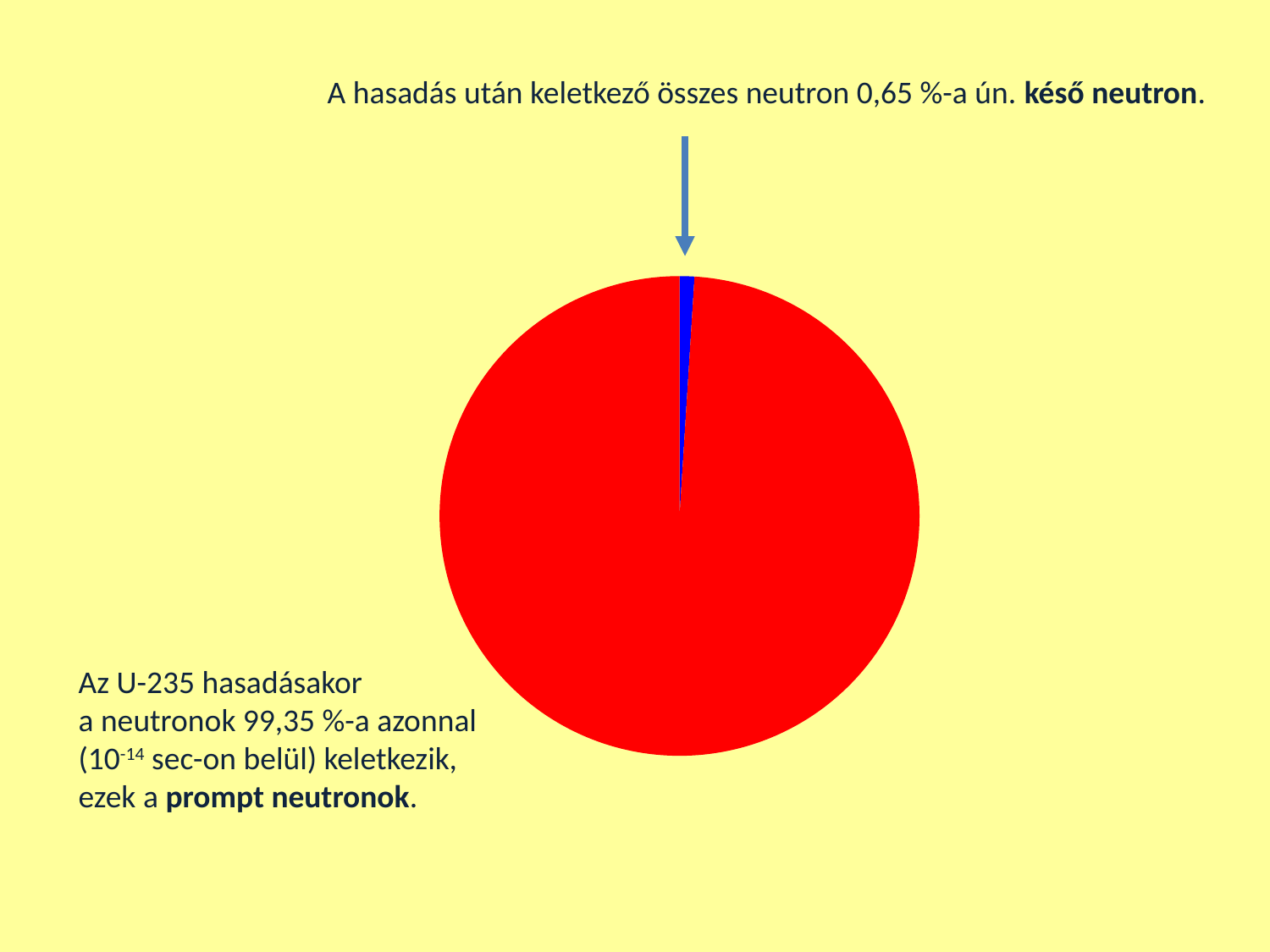
What share of the pie does the red slice (prompt neutronok) represent? 99,35 % What does the arrow above the pie chart point to? the blue slice (késő neutron) What is the difference between the share of prompt neutrons (99,35 %) and the share of delayed neutrons (0,65 %)? 98,7 % Which is larger: the share of prompt neutrons or the share of delayed (késő) neutrons? prompt neutrons What kind of chart is shown on the slide? pie chart What colour is the slice representing the késő neutron (delayed neutron) share? blue Which slice of the pie chart is the largest? the red slice (prompt neutronok) Which slice of the pie chart is the smallest? the blue slice (késő neutron) Is the share of the red slice greater or less than 50 %? greater How many slices does the pie chart have? 2 What share of the pie does the blue slice (késő neutron) represent? 0,65 %